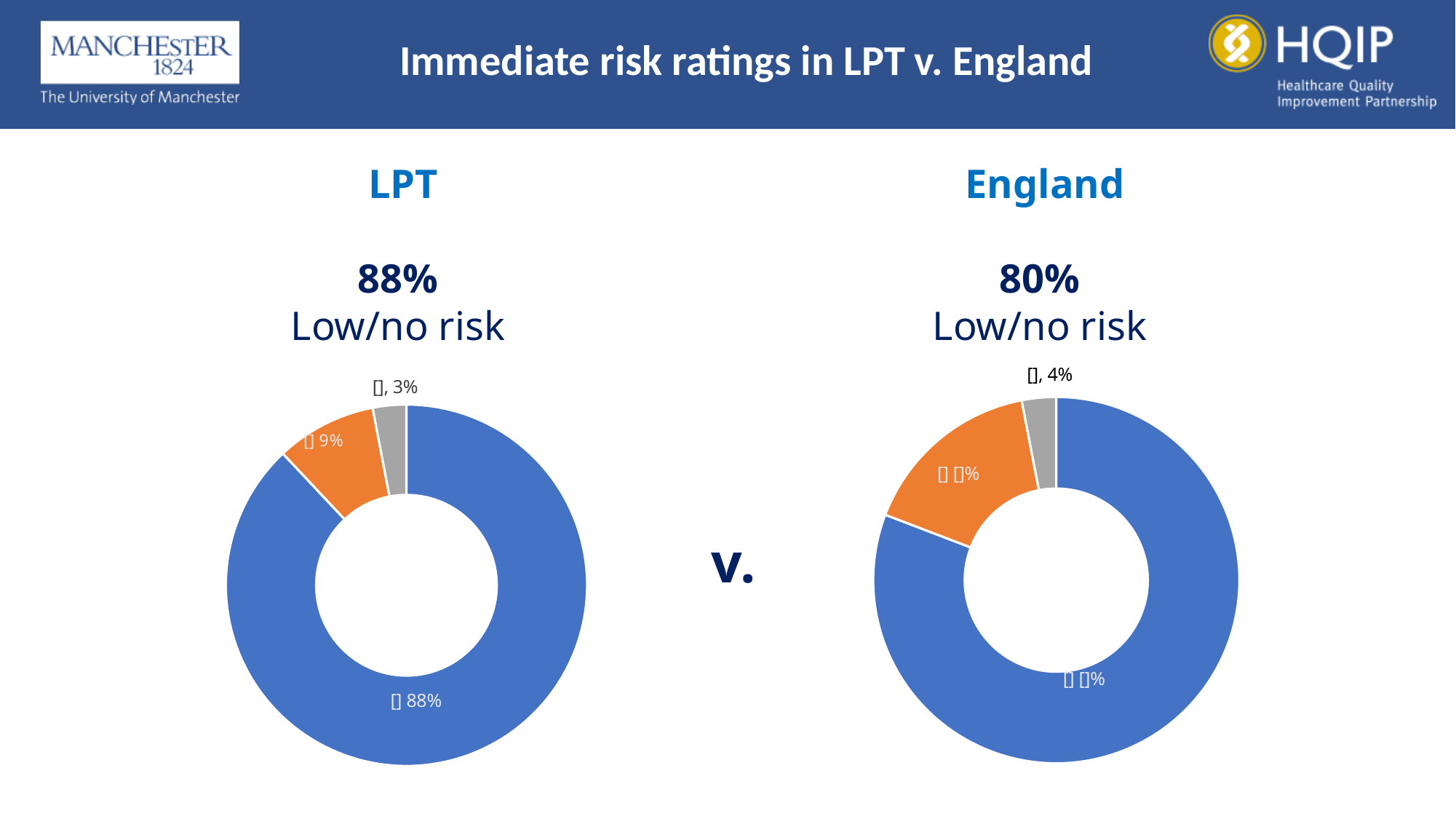
What is the title of the slide containing the two charts? Immediate risk ratings in LPT v. England In the LPT chart, what percentage is shown for the blue (Low/no risk) slice? 88% In the England chart, what percentage is given for Low/no risk? 80% In the England chart, which colour slice is the largest? blue In the LPT chart, what percentage is shown for the grey slice? 3% In the LPT chart, which colour slice is the smallest? grey In the England chart, what percentage is shown for the grey slice? 4% How many slices does the LPT doughnut chart have? 3 In the LPT chart, what percentage is shown for the orange slice? 9% Which has the larger Low/no risk share, LPT or England? LPT What is the difference in percentage points between the Low/no risk share in LPT and in England? 8 percentage points What kind of chart is used on this slide for LPT and England? doughnut chart